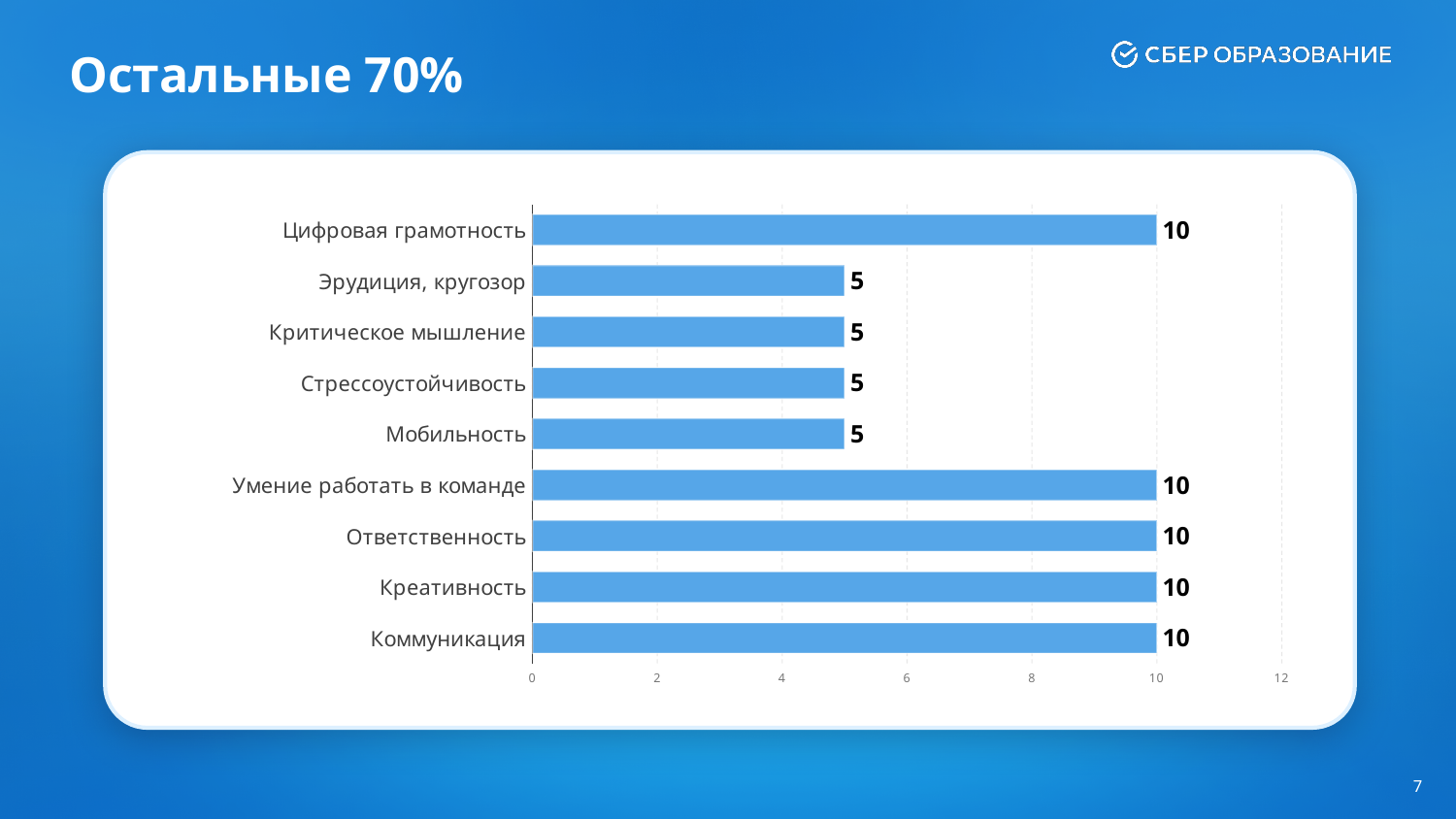
What is the title of the slide? Остальные 70% What is the value for Коммуникация? 10 Is the value for Критическое мышление greater or less than 6? less Which is larger, the value for Креативность or the value for Критическое мышление? Креативность What kind of chart is shown on the slide? bar chart What is the value for Эрудиция, кругозор? 5 What is the value for Цифровая грамотность? 10 How many categories have a value of 5? 4 What is the value for Мобильность? 5 What is the difference between the values for Умение работать в команде and Стрессоустойчивость? 5 Is the value for Ответственность greater or less than 8? greater How many categories are shown in the chart? 9